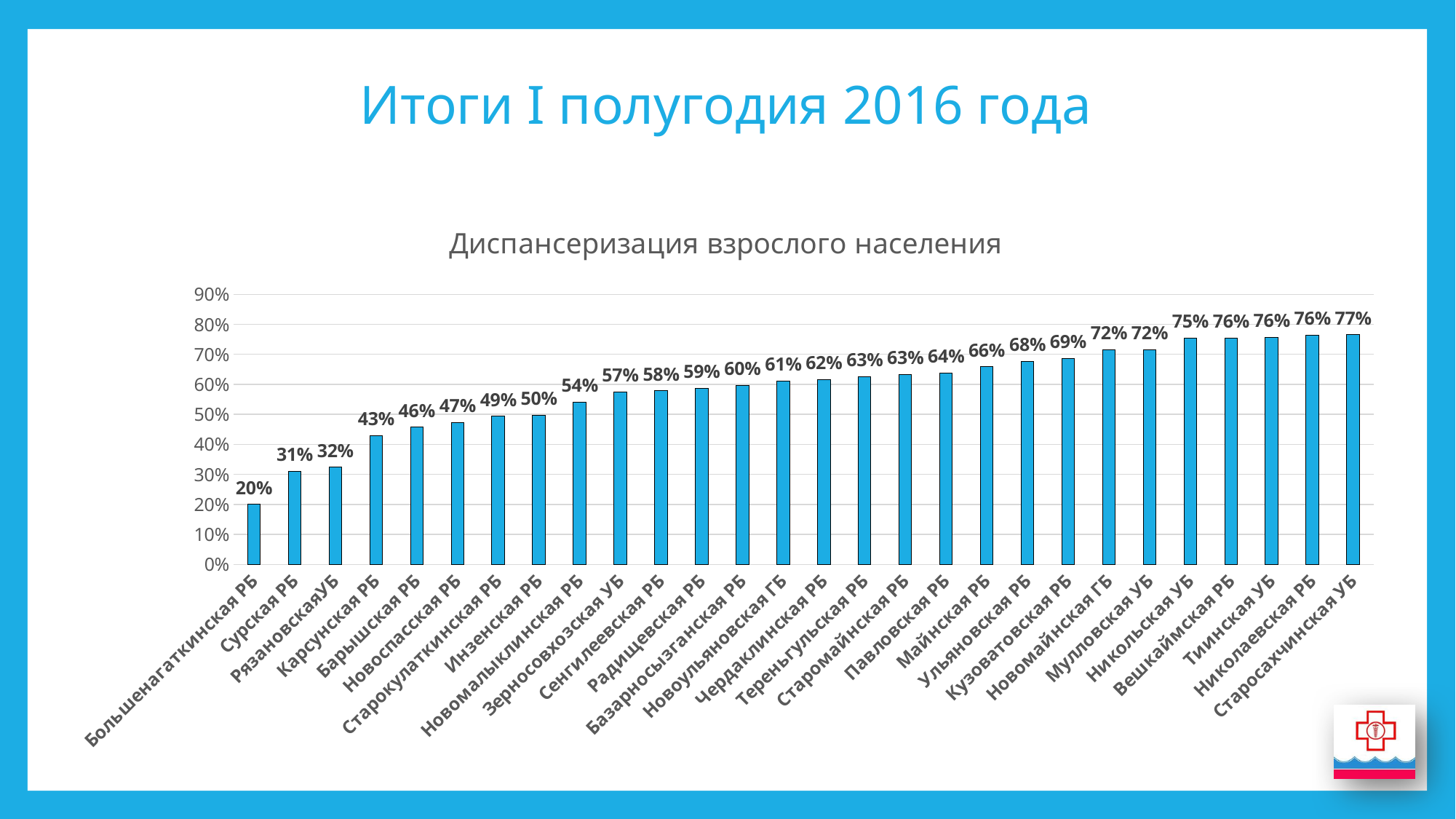
What kind of chart is shown on the slide? bar chart What is the value for Новоульяновская ГБ? 61% What is the difference between the values for Старосахчинская УБ and Большенагаткинская РБ? 57% How many categories are shown in the chart? 28 What is the difference between the values for Майнская РБ and Инзенская РБ? 16% What is the value for Кузоватовская РБ? 69% Which category has the lowest value? Большенагаткинская РБ Which category has the highest value? Старосахчинская УБ What is the value for Карсунская РБ? 43% Which is larger, the value for Сурская РБ or the value for Барышская РБ? Барышская РБ What is the title of the chart? Диспансеризация взрослого населения Is the value for Никольская УБ greater or less than 70%? greater